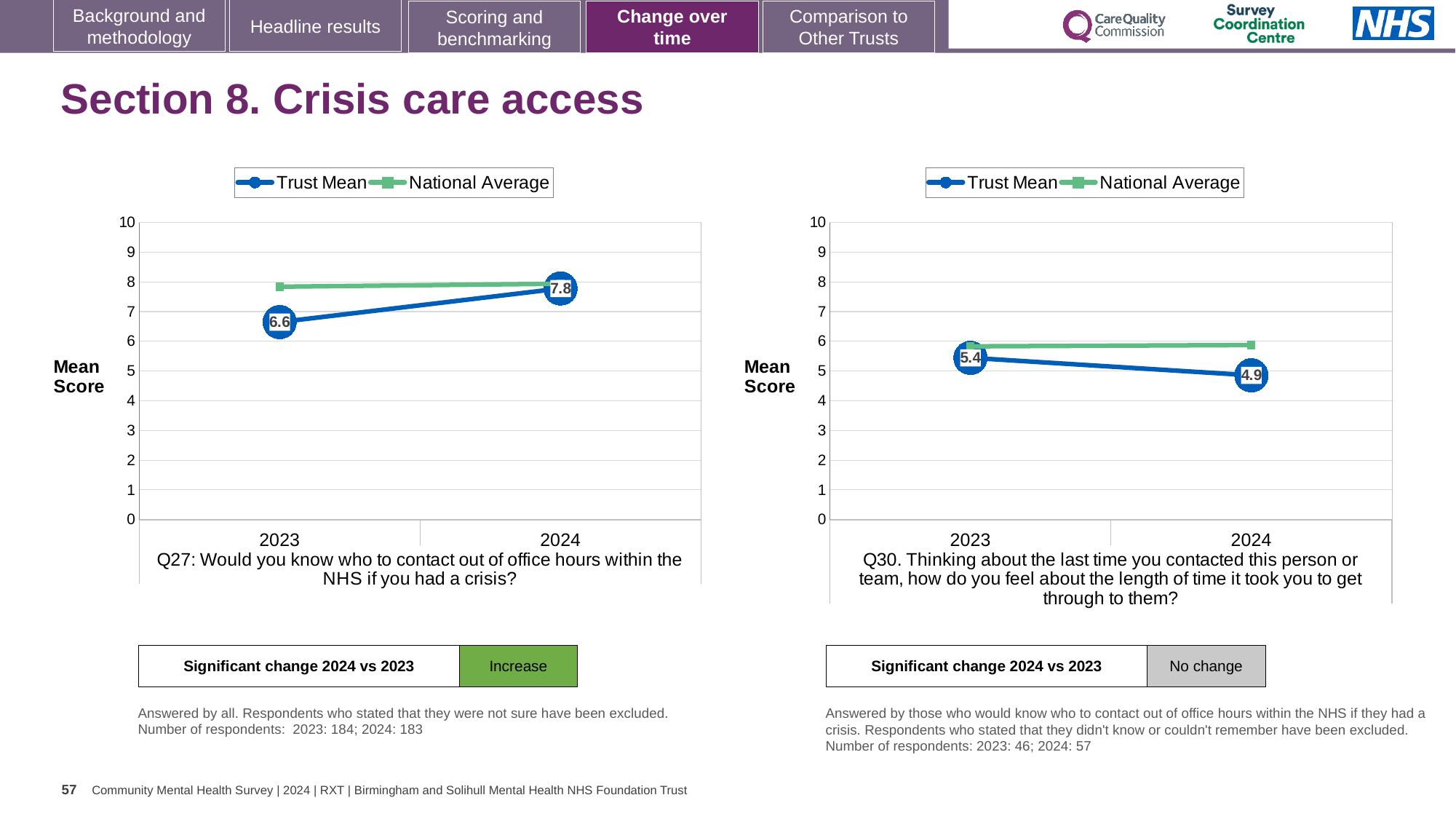
What kind of chart is used on the left of the slide (Q27)? line chart On the right chart (Q30), what is the Trust Mean score for 2024? 4.9 On the right chart (Q30), which is larger in 2024: the Trust Mean or the National Average? National Average On the left chart (Q27), what is the Trust Mean score for 2023? 6.6 On the right chart (Q30), does the Trust Mean rise or fall from 2023 to 2024? fall On the left chart (Q27), is the National Average value for 2023 greater or less than 7? greater How many series does the legend of the right chart (Q30) list? 2 On the left chart (Q27), by how much did the Trust Mean change from 2023 to 2024? 1.2 On the left chart (Q27), does the Trust Mean rise or fall from 2023 to 2024? rise On the right chart (Q30), what is the difference between the Trust Mean in 2023 and 2024? 0.5 On the right chart (Q30), what is the Trust Mean score for 2023? 5.4 On the left chart (Q27), what is the Trust Mean score for 2024? 7.8